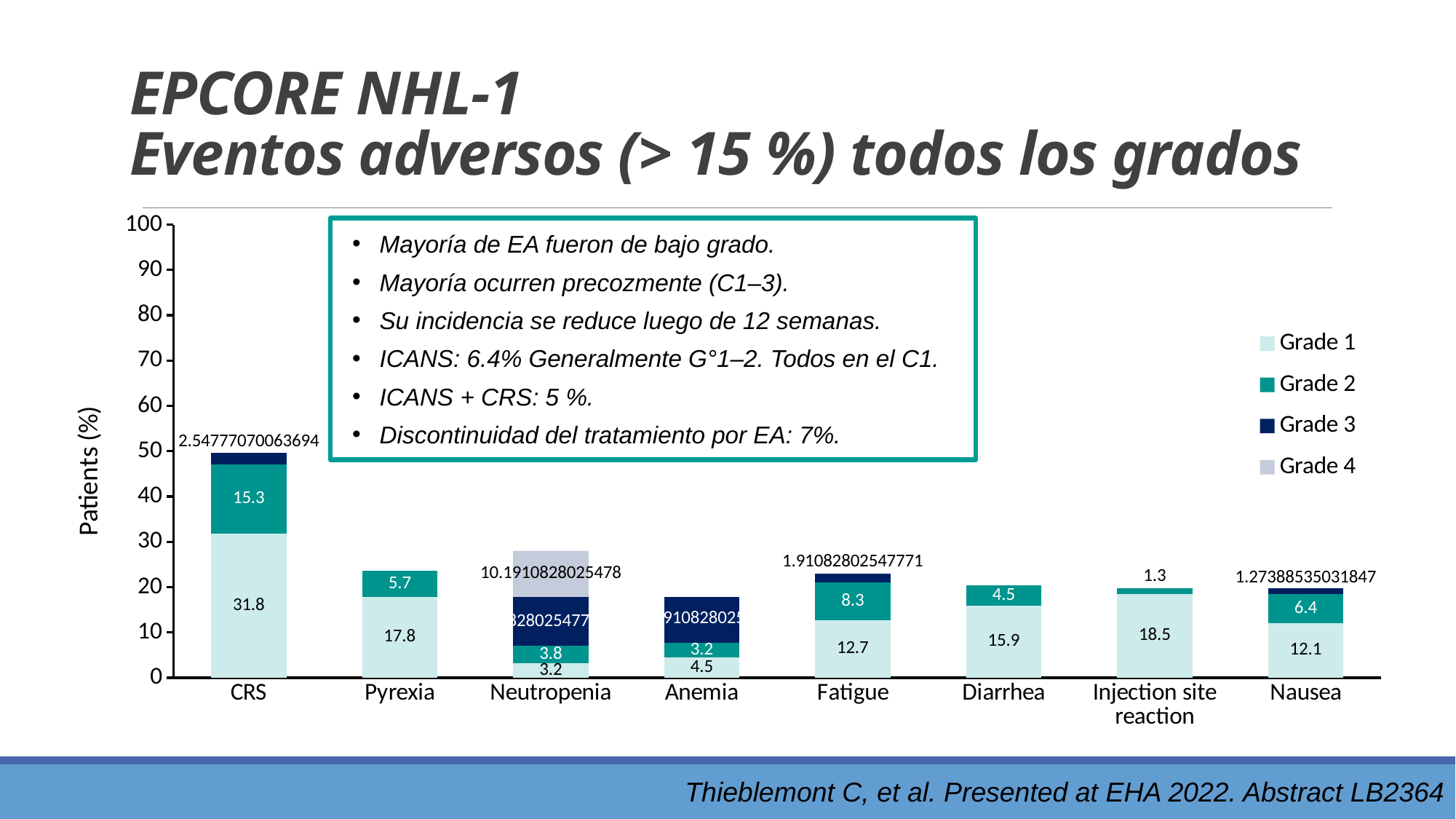
What is the Grade 1 value for CRS? 31.8 What is the difference between the Grade 1 values for Pyrexia and Diarrhea? 1.9 How many series does the legend list? 4 What is the total of the stacked bar for Pyrexia? 23.5 How many adverse event categories are shown on the x axis? 8 What is the Grade 2 value for Fatigue? 8.3 What is the Grade 1 value for Injection site reaction? 18.5 Is the total height of the CRS bar greater or less than 40? greater What is the Grade 2 value for Nausea? 6.4 Which category has the lowest Grade 1 value? Neutropenia Which is larger, the Grade 2 value for Pyrexia or the Grade 2 value for Diarrhea? Pyrexia Which category has the highest Grade 1 value? CRS